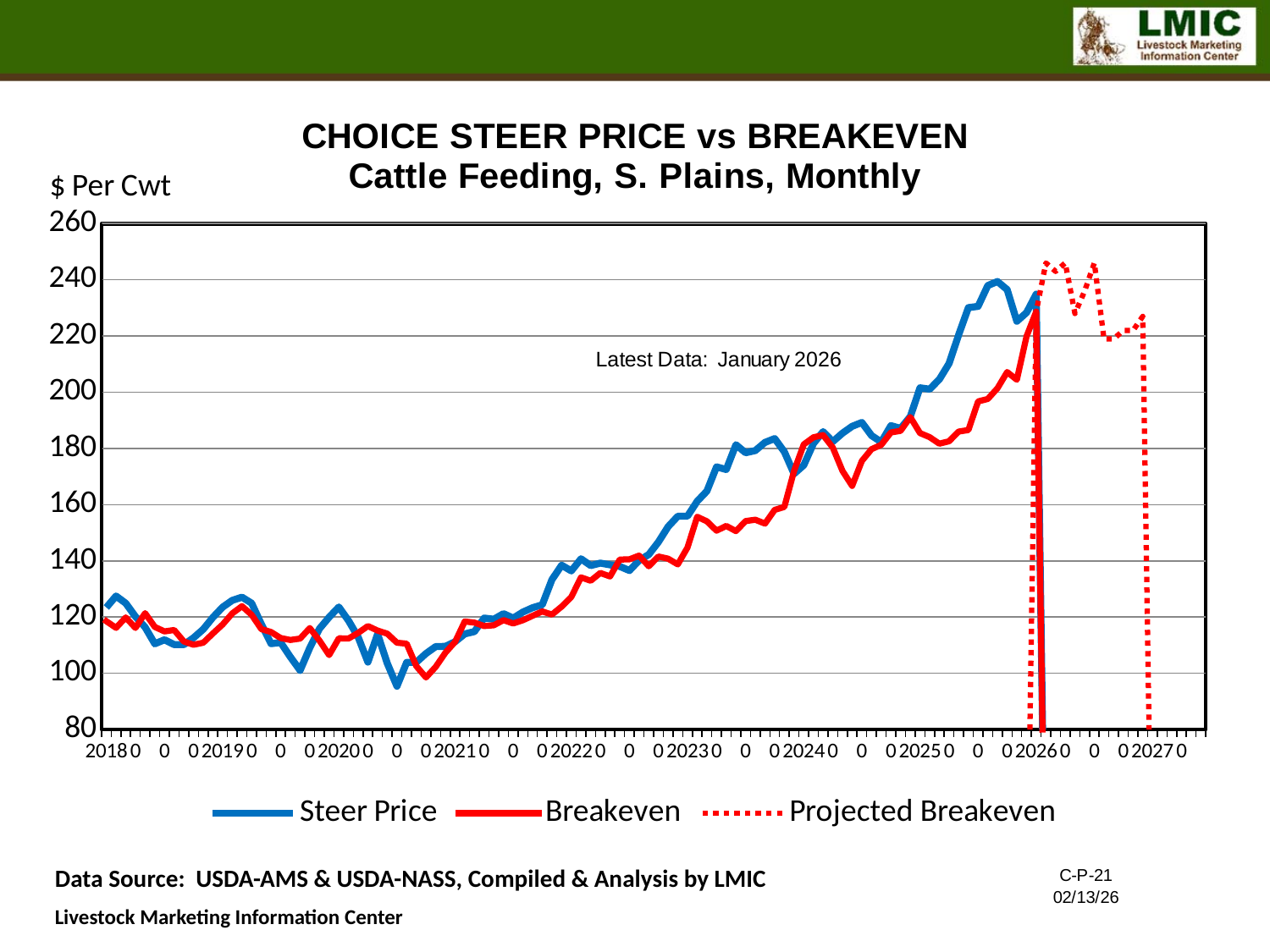
According to the annotation on the chart, what is the latest data month? January 2026 How many series does the legend list? 3 What unit is shown on the y axis of the chart? $ Per Cwt What kind of chart is shown on the slide? Line chart Is the lowest Steer Price value in 2020 greater or less than 100? less How many years are labeled on the x axis, from 2018 to 2027? 10 In mid-2025, which is higher, the Steer Price or the Breakeven? Steer Price Does the Steer Price series generally rise or fall between 2021 and 2025? Rise Is the Steer Price value at the end of 2025 greater or less than 220? greater Is the Breakeven value in mid-2023 greater or less than 140? greater